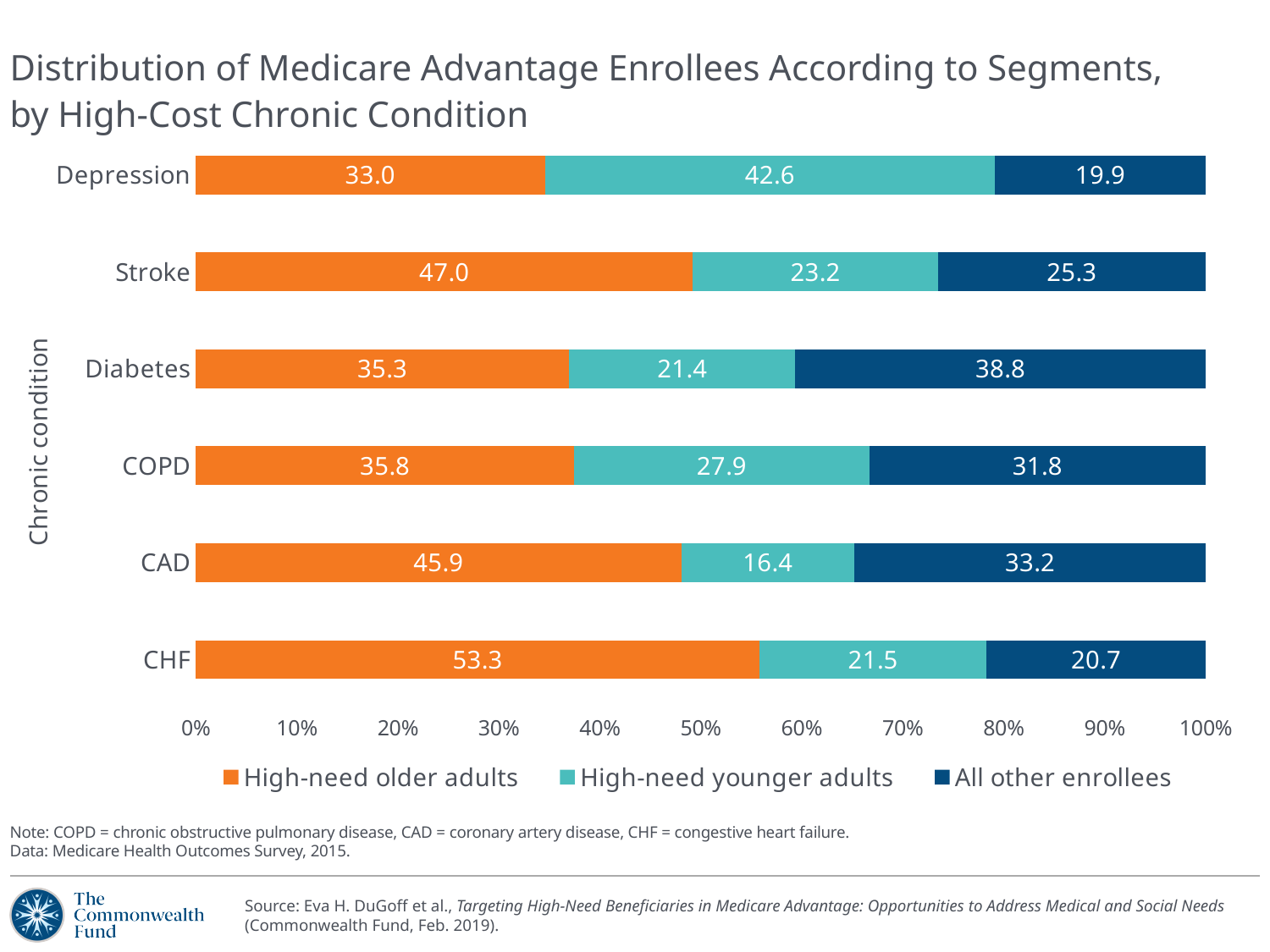
For Stroke, what is the difference between the High-need older adults value and the High-need younger adults value? 23.8 Which is larger: the All other enrollees value for COPD or for CAD? CAD Which chronic condition has the highest value for All other enrollees? Diabetes What kind of chart is shown on the slide? Stacked bar chart How many series does the legend list? 3 What is the value for High-need older adults in the CHF bar? 53.3 Which chronic condition has the lowest value for High-need younger adults? CAD What is the value for All other enrollees in the Diabetes bar? 38.8 How many chronic conditions are shown on the chart? 6 What is the value for High-need younger adults in the Depression bar? 42.6 Which chronic condition has the highest value for High-need older adults? CHF What colour represents High-need older adults in the legend? Orange